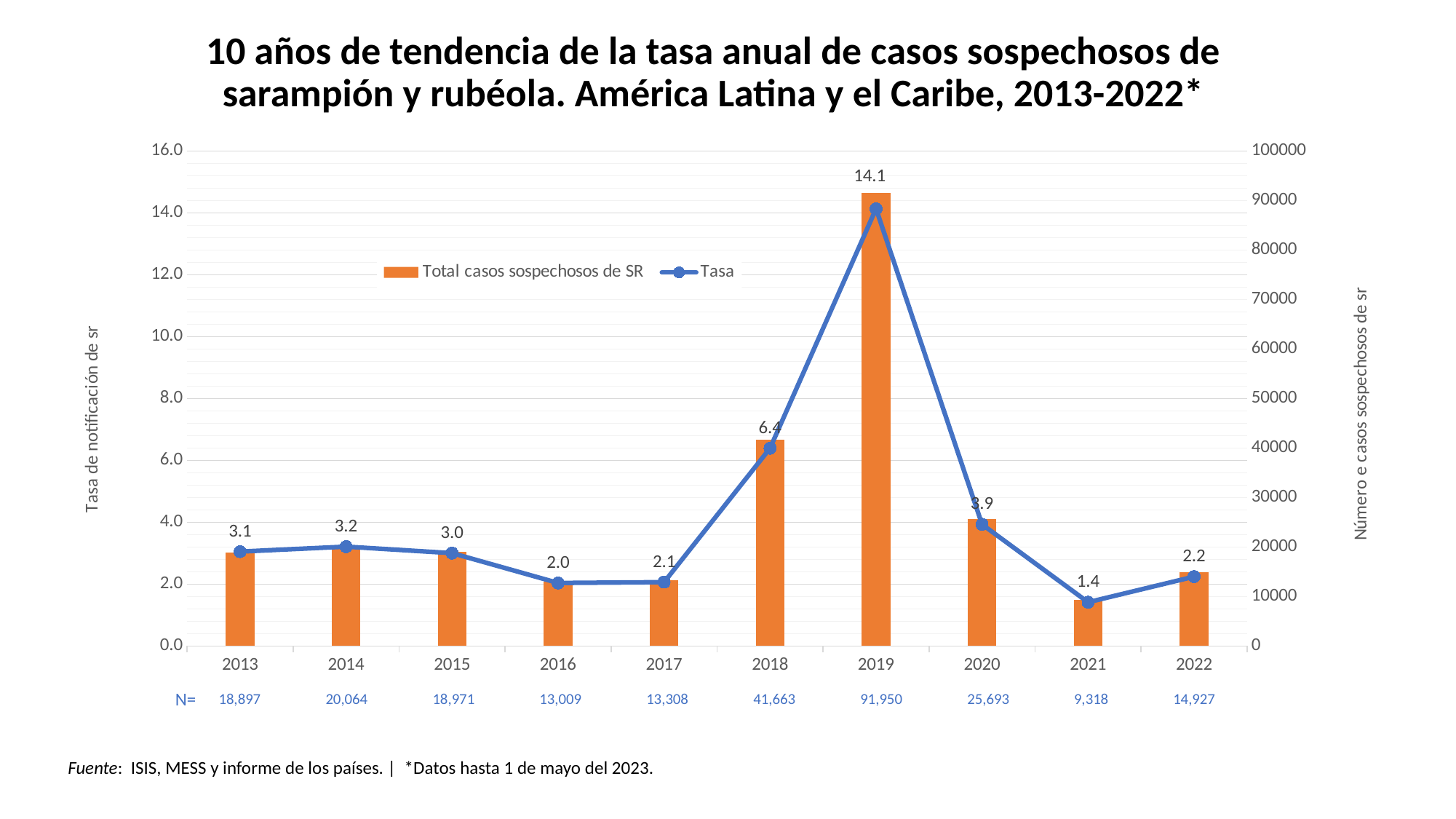
How many series does the legend list? 2 What is the Tasa value for 2019? 14.1 Is the bar for 2019 (Total casos sospechosos de SR) greater or less than 80000 on the right axis? greater Does the Tasa line rise or fall from 2019 to 2021? Fall What kind of chart is this? Combination bar and line chart What is the Tasa value for 2021? 1.4 What is the N= value (total suspected cases) shown for 2018? 41,663 Which year has the lowest Tasa value? 2021 How many years are shown on the x axis? 10 Which year has the highest Tasa value? 2019 Which year has the larger Tasa value, 2014 or 2015? 2014 What is the difference between the Tasa values for 2019 and 2018? 7.7